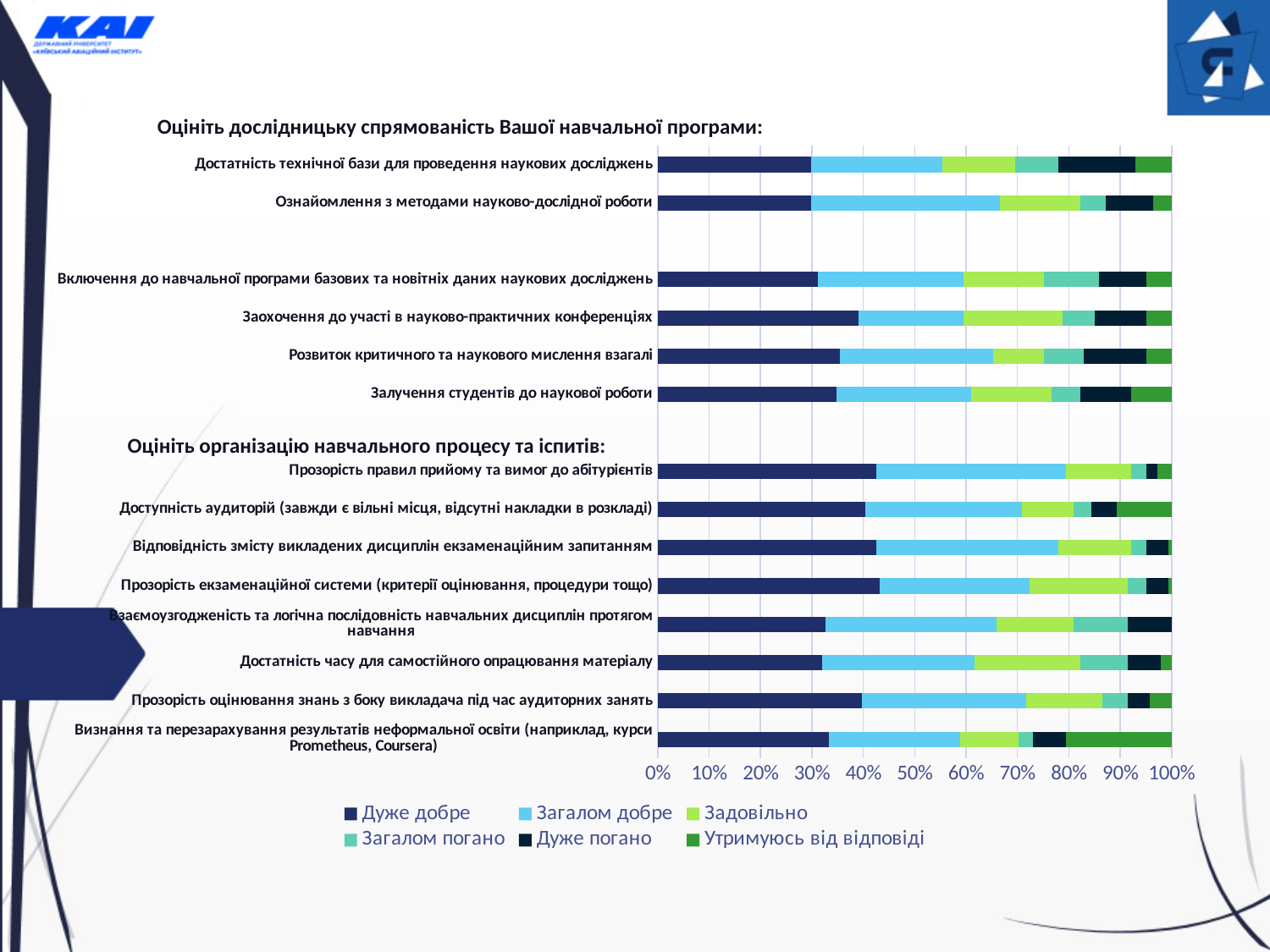
Is the "Дуже добре" share for "Прозорість правил прийому та вимог до абітурієнтів" greater or less than 30%? greater Which has a larger "Дуже добре" share: "Прозорість правил прийому та вимог до абітурієнтів" or "Достатність технічної бази для проведення наукових досліджень"? Прозорість правил прийому та вимог до абітурієнтів Is the "Дуже добре" share for "Взаємоузгодженість та логічна послідовність навчальних дисциплін протягом навчання" greater or less than 40%? less Is the "Дуже добре" share for "Достатність технічної бази для проведення наукових досліджень" greater or less than 40%? less What kind of chart is shown on the slide? Stacked bar chart Which category has the largest share of "Утримуюсь від відповіді"? Визнання та перезарахування результатів неформальної освіти (наприклад, курси Prometheus, Coursera) What is the first series listed in the chart legend? Дуже добре What is the highest value shown on the horizontal axis of the chart? 100% Which has a larger "Утримуюсь від відповіді" share: "Визнання та перезарахування результатів неформальної освіти" or "Прозорість правил прийому та вимог до абітурієнтів"? Визнання та перезарахування результатів неформальної освіти How many categories (bars) are plotted in the chart? 14 How many series does the chart legend list? 6